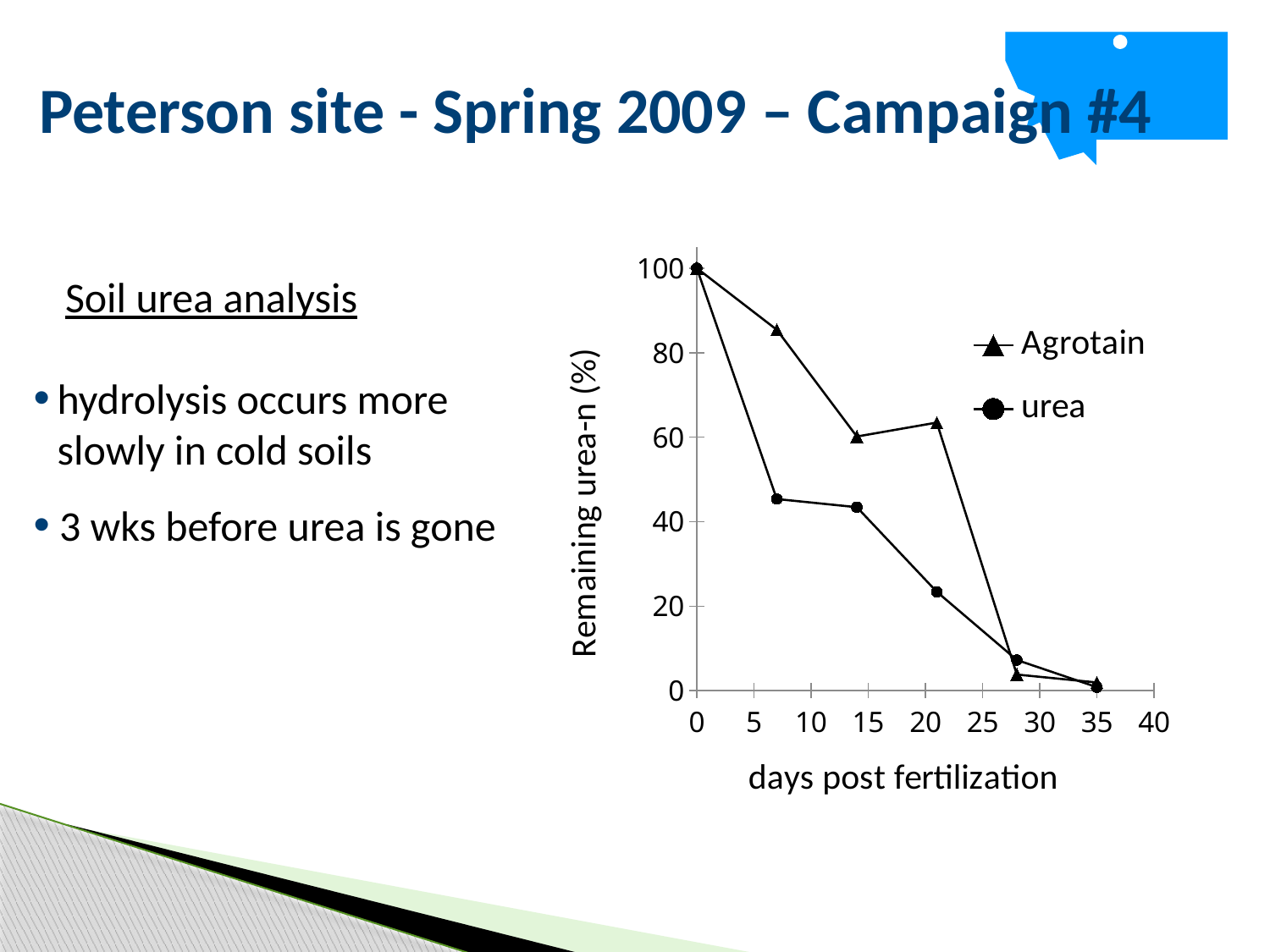
At about day 21, which series has the higher remaining urea-n, Agrotain or urea? Agrotain Is the value for urea at about day 7 greater or less than 60? less What is the remaining urea-n (%) for urea at day 0? 100 What are the two series named in the legend? Agrotain and urea How many series does the legend list? 2 Do the values for urea rise or fall as days post fertilization increase? fall What is the label of the y axis? Remaining urea-n (%) What kind of chart is shown on the slide? line chart How many data points are plotted for the Agrotain series? 6 Is the value for Agrotain at about day 7 greater or less than 80? greater Is the value for urea at about day 21 greater or less than 40? less What is the remaining urea-n (%) for Agrotain at day 0? 100